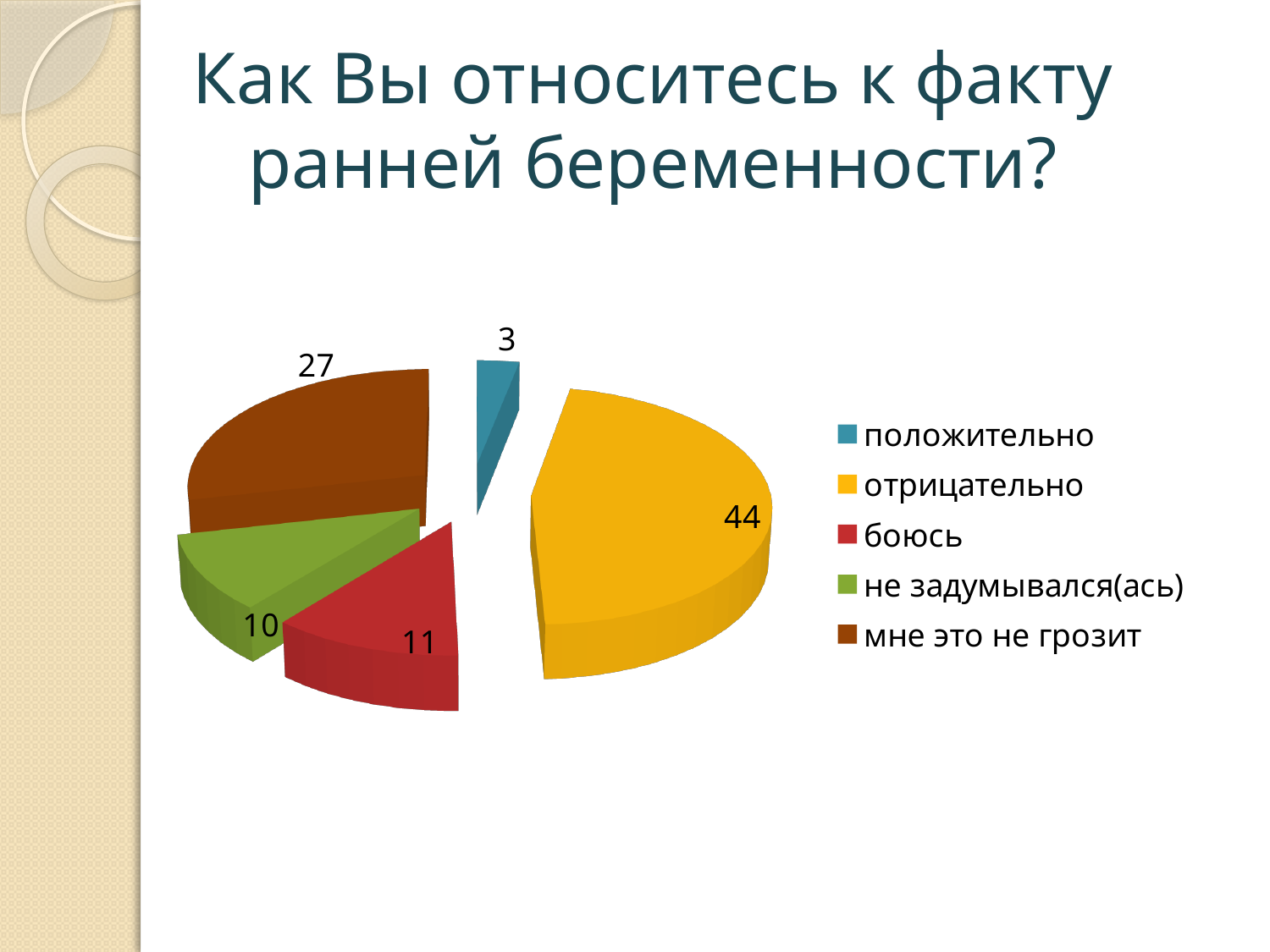
What colour is the slice for "мне это не грозит"? brown Which category has the largest slice of the pie? отрицательно What value is shown for the slice "не задумывался(ась)"? 10 What value is shown for the slice "мне это не грозит"? 27 What is the difference between the values for "отрицательно" and "мне это не грозит"? 17 Which category has the smallest slice of the pie? положительно What value is shown for the slice "боюсь"? 11 What kind of chart is shown on the slide? pie chart How many slices does the pie chart have? 5 Which is larger, the value for "боюсь" or the value for "не задумывался(ась)"? боюсь What value is shown for the slice "положительно"? 3 What value is shown for the slice "отрицательно"? 44